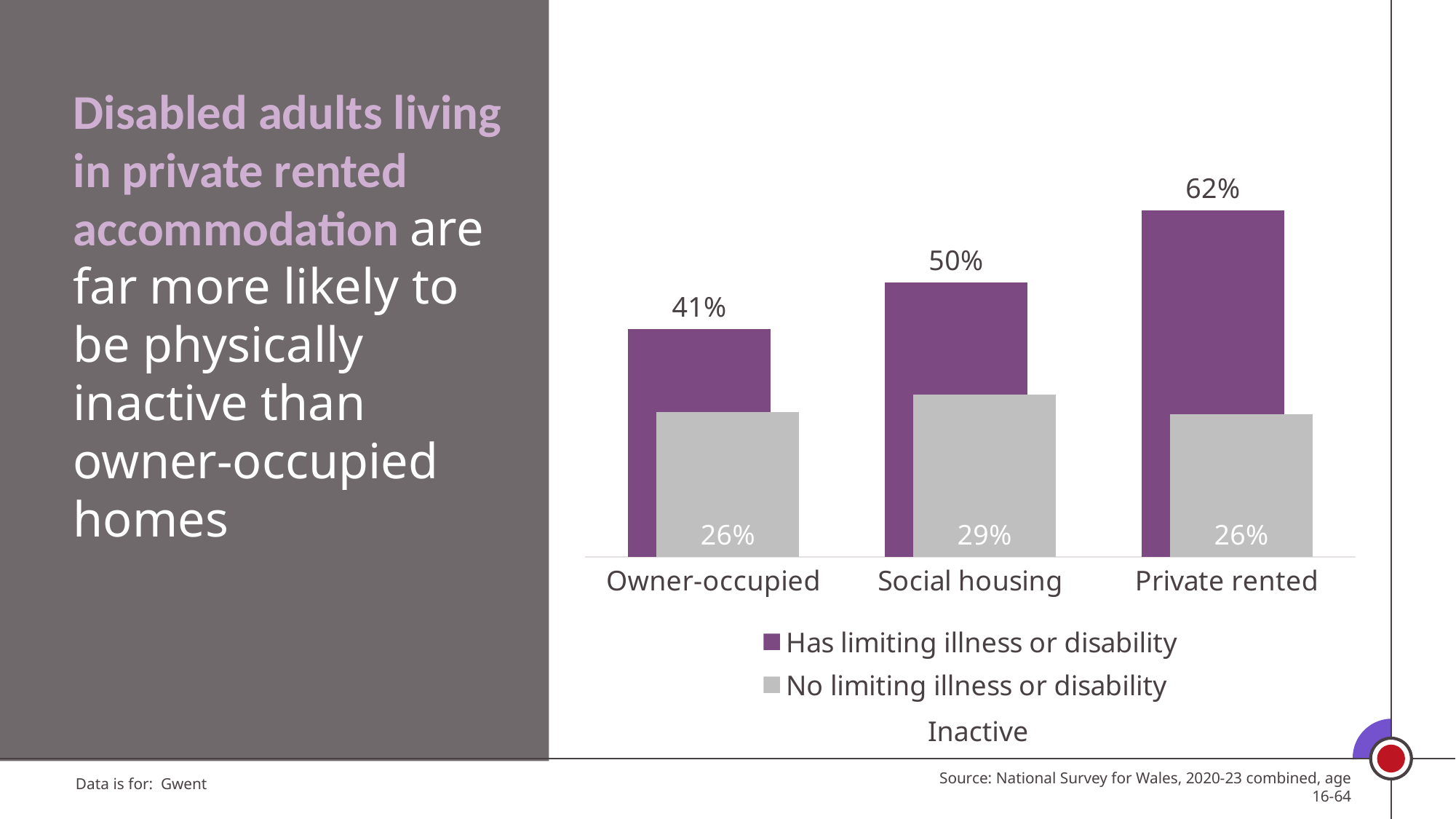
What is the value for 'No limiting illness or disability' in the Social housing category? 29% How many housing categories are shown on the x axis? 3 How many series does the legend list? 2 Which category has the highest value for 'Has limiting illness or disability'? Private rented What is the difference between the 'Has limiting illness or disability' and 'No limiting illness or disability' values in the Private rented category? 36% What is the value for 'Has limiting illness or disability' in the Private rented category? 62% What is the value for 'Has limiting illness or disability' in the Owner-occupied category? 41% What is the difference between the 'Has limiting illness or disability' values for Private rented and Owner-occupied? 21% Which category has the lowest value for 'Has limiting illness or disability'? Owner-occupied What is the label shown below the legend of the chart? Inactive What kind of chart is shown on the slide? Bar chart Which is larger: the 'Has limiting illness or disability' value for Social housing or for Owner-occupied? Social housing